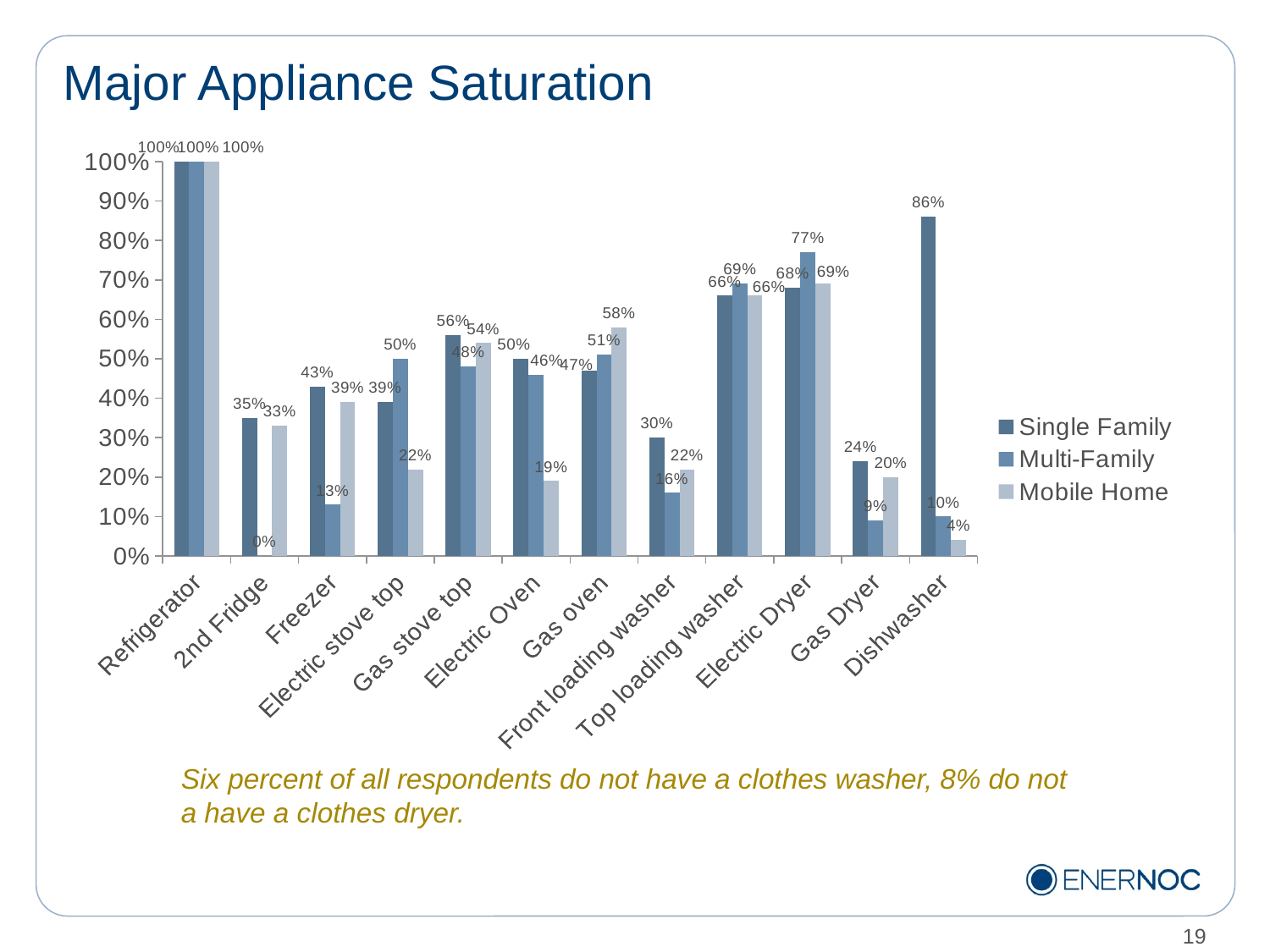
What kind of chart is shown on the slide? Bar chart Which appliance has the lowest Mobile Home value? Dishwasher What is the Single Family value for Dishwasher? 86% What is the Mobile Home value for Gas oven? 58% What is the Multi-Family value for 2nd Fridge? 0% What is the difference between the Single Family and Multi-Family values for Dishwasher? 76% Which is larger for Electric stove top: the Single Family value or the Multi-Family value? Multi-Family What is the Multi-Family value for Electric Dryer? 77% Excluding Refrigerator, which appliance has the highest Single Family value? Dishwasher How many appliance categories are shown on the x axis? 12 What is the title of the chart? Major Appliance Saturation How many series does the legend list? 3